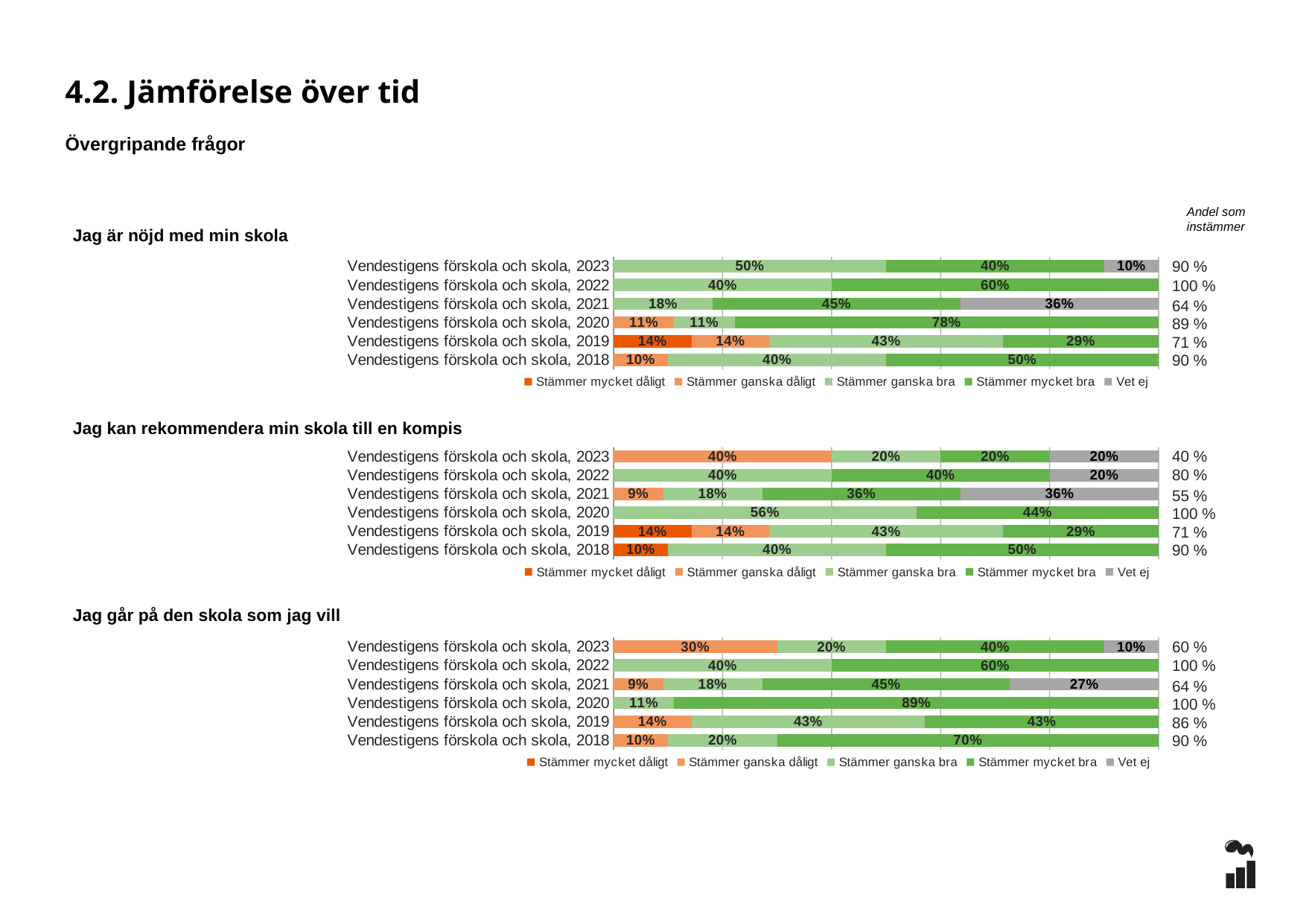
In the chart 'Jag är nöjd med min skola', what is the 'Vet ej' value for Vendestigens förskola och skola, 2021? 36% In the chart 'Jag kan rekommendera min skola till en kompis', what is the difference between the 'Stämmer mycket bra' values for 2018 and 2023? 30% In the chart 'Jag går på den skola som jag vill', what is the 'Vet ej' value for Vendestigens förskola och skola, 2021? 27% In the chart 'Jag går på den skola som jag vill', what is the 'Stämmer mycket bra' value for Vendestigens förskola och skola, 2018? 70% In the chart 'Jag kan rekommendera min skola till en kompis', which year has the highest 'Stämmer ganska bra' value? Vendestigens förskola och skola, 2020 In the chart 'Jag går på den skola som jag vill', which is larger: the 'Stämmer ganska dåligt' value for 2023 or for 2019? 2023 How many series does the legend list in the chart 'Jag är nöjd med min skola'? 5 In the chart 'Jag kan rekommendera min skola till en kompis', what is the 'Stämmer ganska dåligt' value for Vendestigens förskola och skola, 2023? 40% In the chart 'Jag är nöjd med min skola', which year has the highest 'Stämmer mycket bra' value? Vendestigens förskola och skola, 2020 What kind of chart is 'Jag går på den skola som jag vill'? Stacked bar chart In the chart 'Jag är nöjd med min skola', what is the 'Stämmer mycket bra' value for Vendestigens förskola och skola, 2020? 78% How many bars (years) are shown in the chart 'Jag kan rekommendera min skola till en kompis'? 6